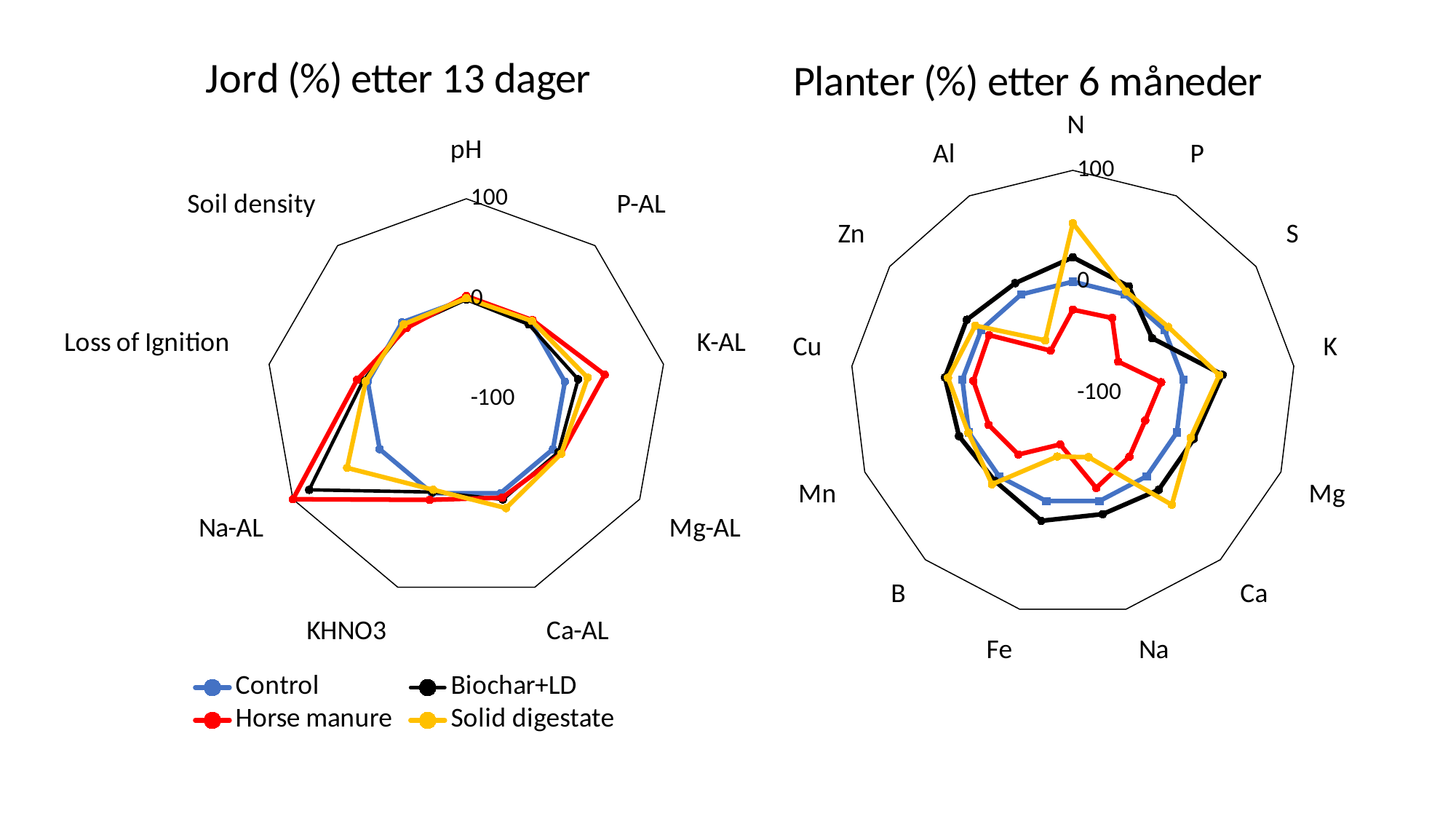
How many categories (axes) does the chart titled "Jord (%) etter 13 dager" have? 9 In the chart titled "Planter (%) etter 6 måneder", is the Horse manure value for Cu greater or less than 0? less What kind of chart is the chart titled "Jord (%) etter 13 dager"? Radar chart How many categories (axes) does the chart titled "Planter (%) etter 6 måneder" have? 13 In the chart titled "Jord (%) etter 13 dager", for Na-AL, which is larger: Horse manure or Solid digestate? Horse manure In the chart titled "Jord (%) etter 13 dager", is the Horse manure value for Na-AL greater or less than 0? greater In the legend, which series is shown in red? Horse manure In the chart titled "Planter (%) etter 6 måneder", is the Solid digestate value for N greater or less than 0? greater How many series does the legend list? 4 In the chart titled "Planter (%) etter 6 måneder", for N, which is larger: Solid digestate or Horse manure? Solid digestate What is the title of the chart on the right of the slide? Planter (%) etter 6 måneder In the chart titled "Jord (%) etter 13 dager", which category has the highest Horse manure value? Na-AL